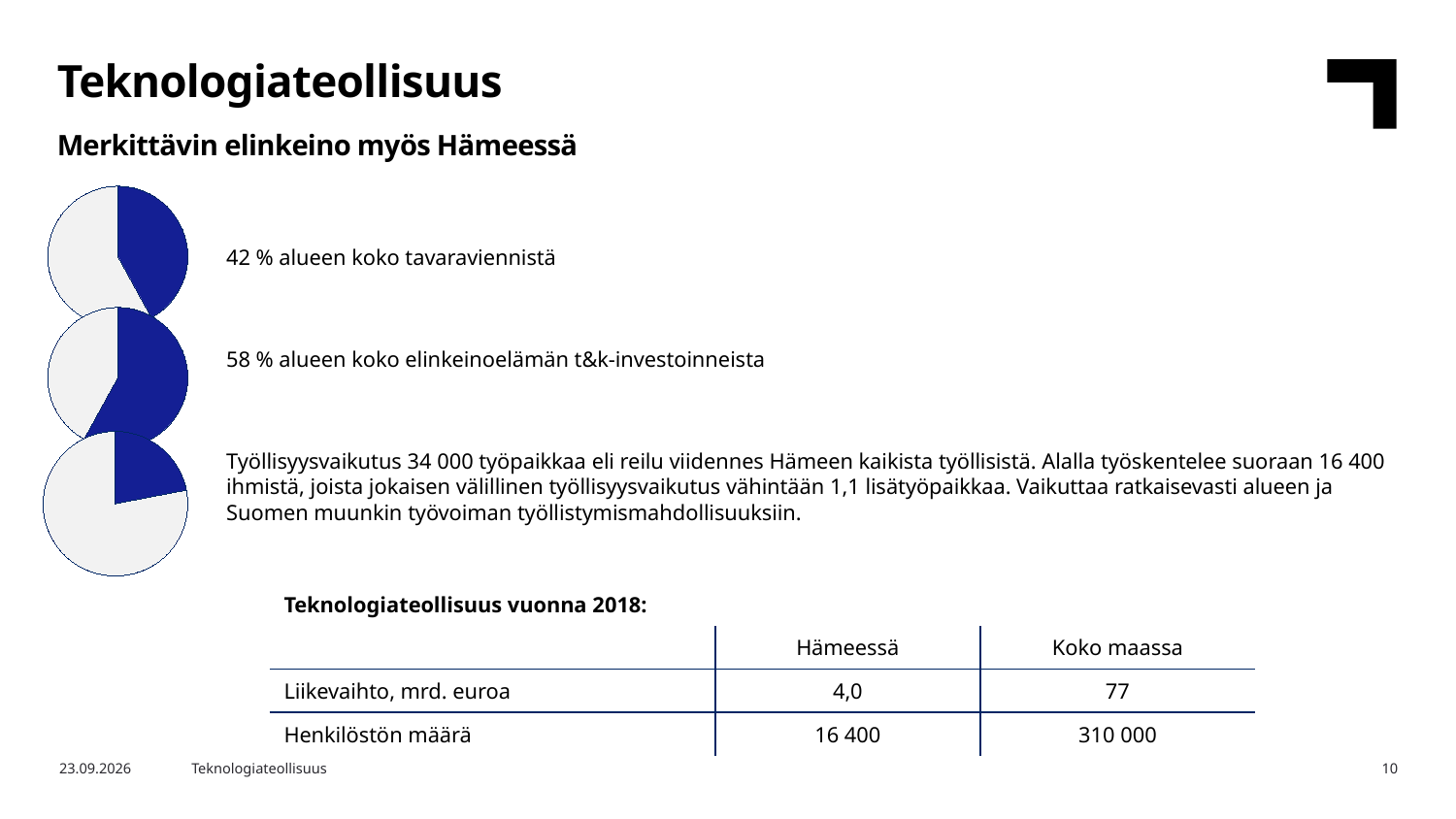
In the bottom pie chart, is the blue slice greater or less than 50%? less In the middle pie chart, is the blue slice greater or less than 50%? greater What is the difference in percentage points between the blue shares of the middle pie chart (58 %) and the top pie chart (42 %)? 16 percentage points What is the title of the slide containing the pie charts? Teknologiateollisuus What two colours are used in the pie charts? Blue and light grey Which of the three pie charts has the smallest blue slice? The bottom one (työllisyysvaikutus) In the top pie chart, what share of the region's total goods exports (tavaravienti) does the blue slice represent? 42 % What kind of charts are shown on the left side of the slide? Pie charts Which pie chart has the larger blue slice, the top one (tavaravienti) or the middle one (t&k-investoinnit)? The middle one (t&k-investoinnit) In the middle pie chart, what share of the region's business R&D investments (t&k-investoinnit) does the blue slice represent? 58 % How many pie charts are on the slide? 3 Which of the three pie charts has the largest blue slice? The middle one (t&k-investoinnit)